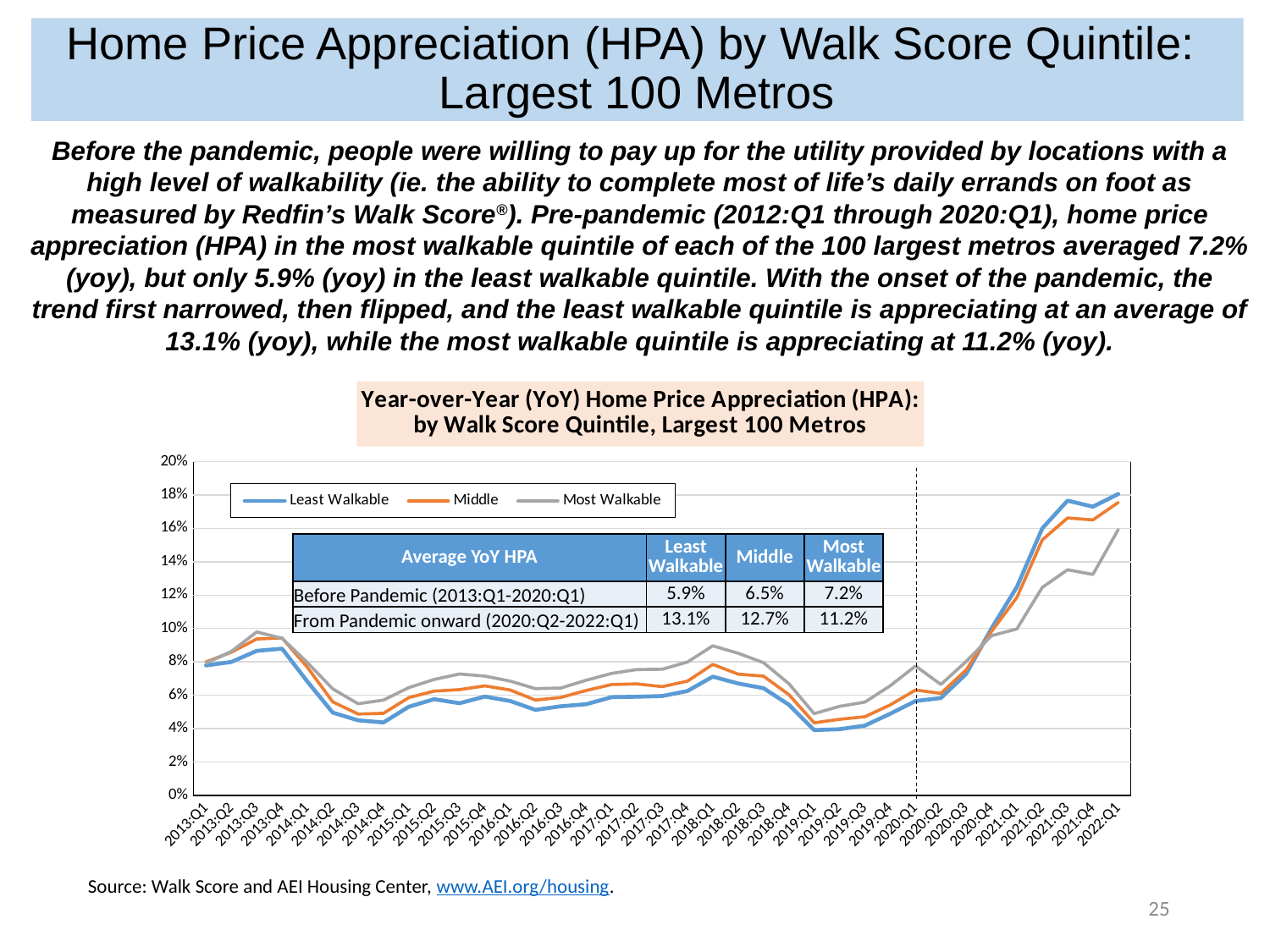
Using the table in the chart, what is the difference between the Least Walkable and Most Walkable average YoY HPA from the pandemic onward? 1.9% Does the Least Walkable line rise or fall from 2019:Q1 to 2022:Q1? rise Using the table in the chart, what is the difference between the Most Walkable and Least Walkable average YoY HPA before the pandemic? 1.3% According to the table in the chart, what is the average YoY HPA for the Least Walkable quintile from the pandemic onward (2020:Q2-2022:Q1)? 13.1% At 2022:Q1, which series has the higher value: Least Walkable or Most Walkable? Least Walkable Is the Least Walkable value at 2022:Q1 greater or less than 16%? greater What kind of chart is shown on the slide? line chart According to the table in the chart, what was the average YoY HPA for the Most Walkable quintile before the pandemic (2013:Q1-2020:Q1)? 7.2% Is the Most Walkable value at 2019:Q1 greater or less than 8%? less How many quarters are shown along the x axis of the chart? 37 According to the table in the chart, what is the average YoY HPA for the Middle quintile before the pandemic? 6.5% How many series does the chart legend list? 3